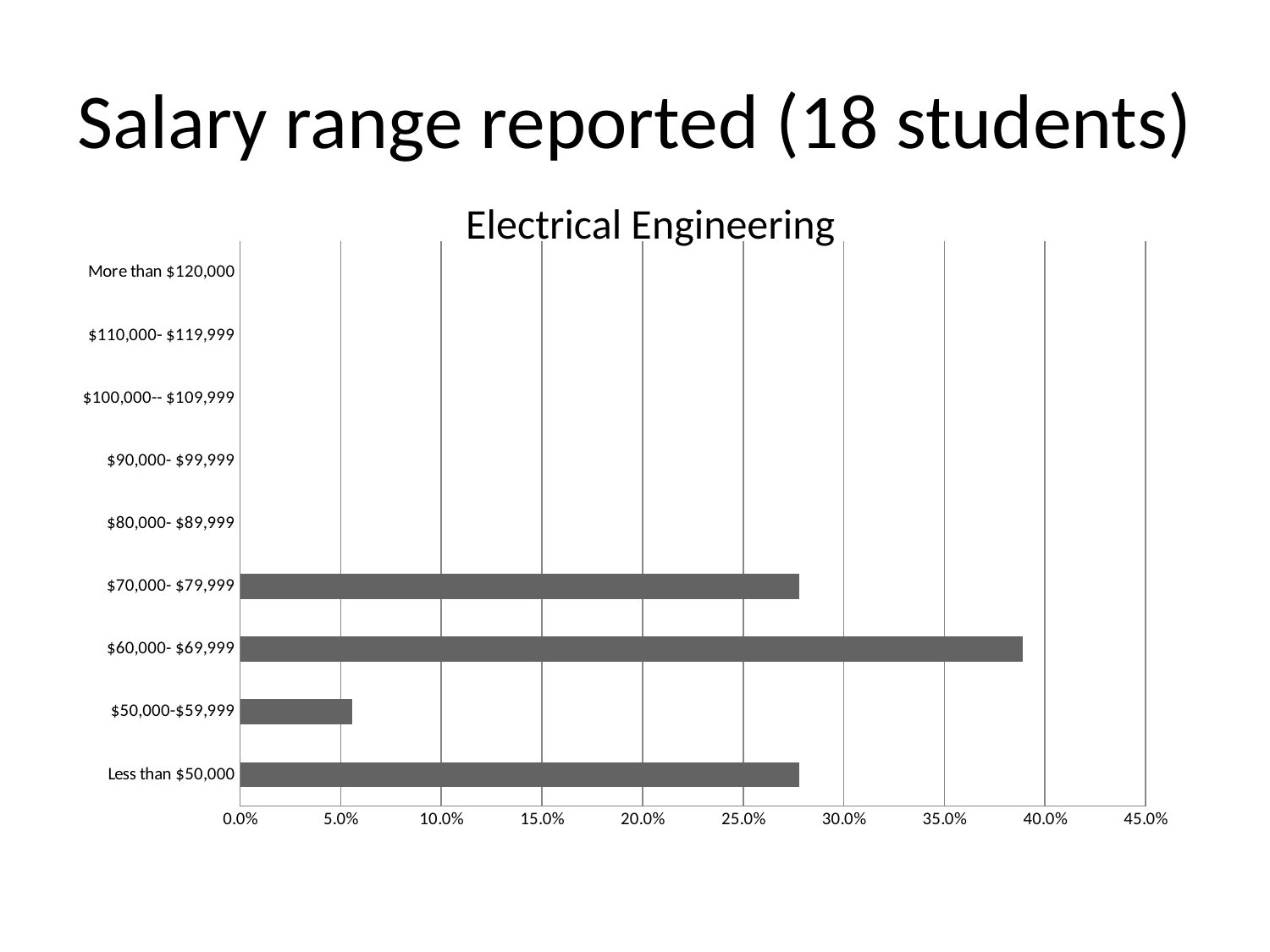
Is the value for $70,000- $79,999 greater or less than 25%? greater Which salary range has the highest reported percentage? $60,000- $69,999 Is the value for Less than $50,000 greater or less than 30%? less What is the title of the chart? Electrical Engineering Which is larger, the value for $50,000-$59,999 or the value for Less than $50,000? Less than $50,000 Is the value for $60,000- $69,999 greater or less than 40%? less Which is larger, the value for $60,000- $69,999 or the value for $70,000- $79,999? $60,000- $69,999 How many salary range categories are listed on the vertical axis? 9 How many salary range categories have a visible bar (a non-zero value)? 4 What kind of chart is shown on the slide? bar chart